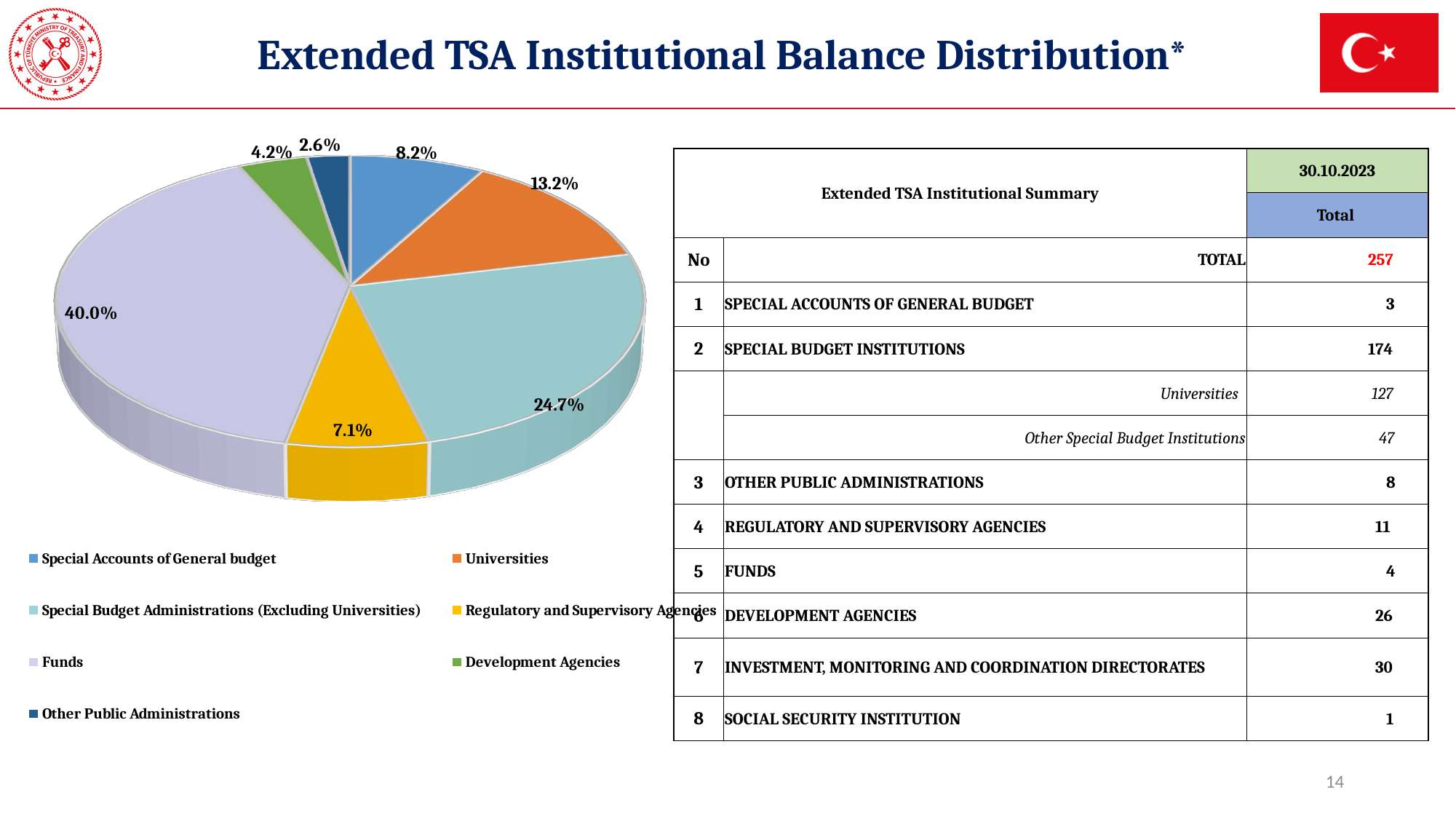
Which category has the smallest slice in the pie chart? Other Public Administrations What share of the pie chart does Funds represent? 40.0% What share of the pie chart does Universities represent? 13.2% What type of chart is shown on the left of the slide? pie chart What share of the pie chart does Special Budget Administrations (Excluding Universities) represent? 24.7% What is the difference in percentage points between the Funds slice and the Special Budget Administrations (Excluding Universities) slice? 15.3 What colour is the Development Agencies slice in the pie chart? green Which slice is larger in the pie chart: Special Accounts of General budget or Universities? Universities How many slices does the pie chart have? 7 Which category has the largest slice in the pie chart? Funds